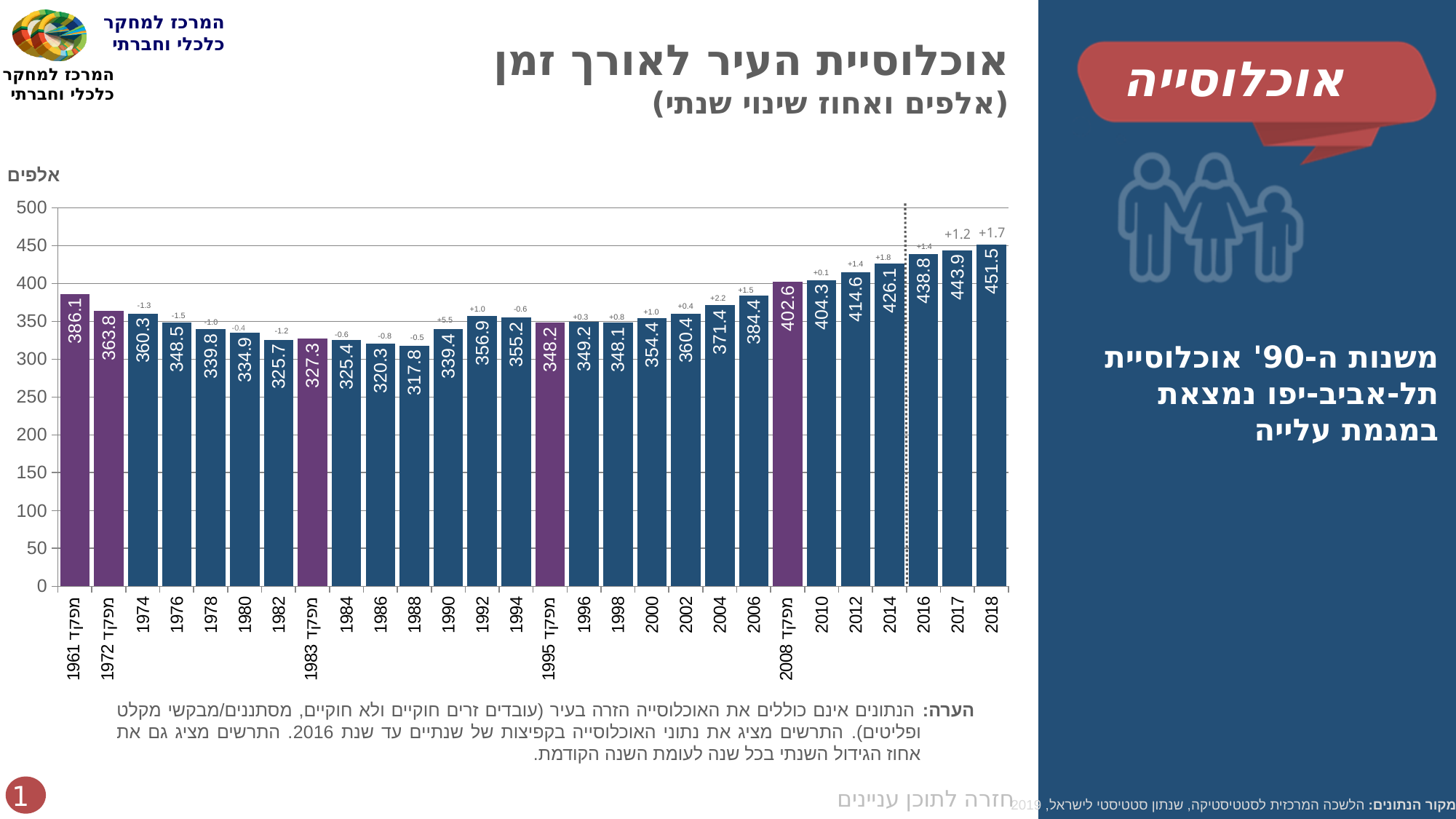
What is the population value shown for the 1961 census (מפקד 1961)? 386.1 What is the population value shown for 2018? 451.5 Do the population values rise or fall from 1995 to 2018? rise Which is larger, the population value for 1961 or for 2006? 1961 What kind of chart is shown on the slide? bar chart Is the population value for 2014 greater or less than 400? greater Which year has the lowest population value in the chart? 1988 What is the population value shown for 1988? 317.8 Which year has the highest population value in the chart? 2018 What is the population value shown for the 2008 census (מפקד 2008)? 402.6 How many bars are shown in the chart? 28 What is the difference between the population values for 2018 and 2017? 7.6